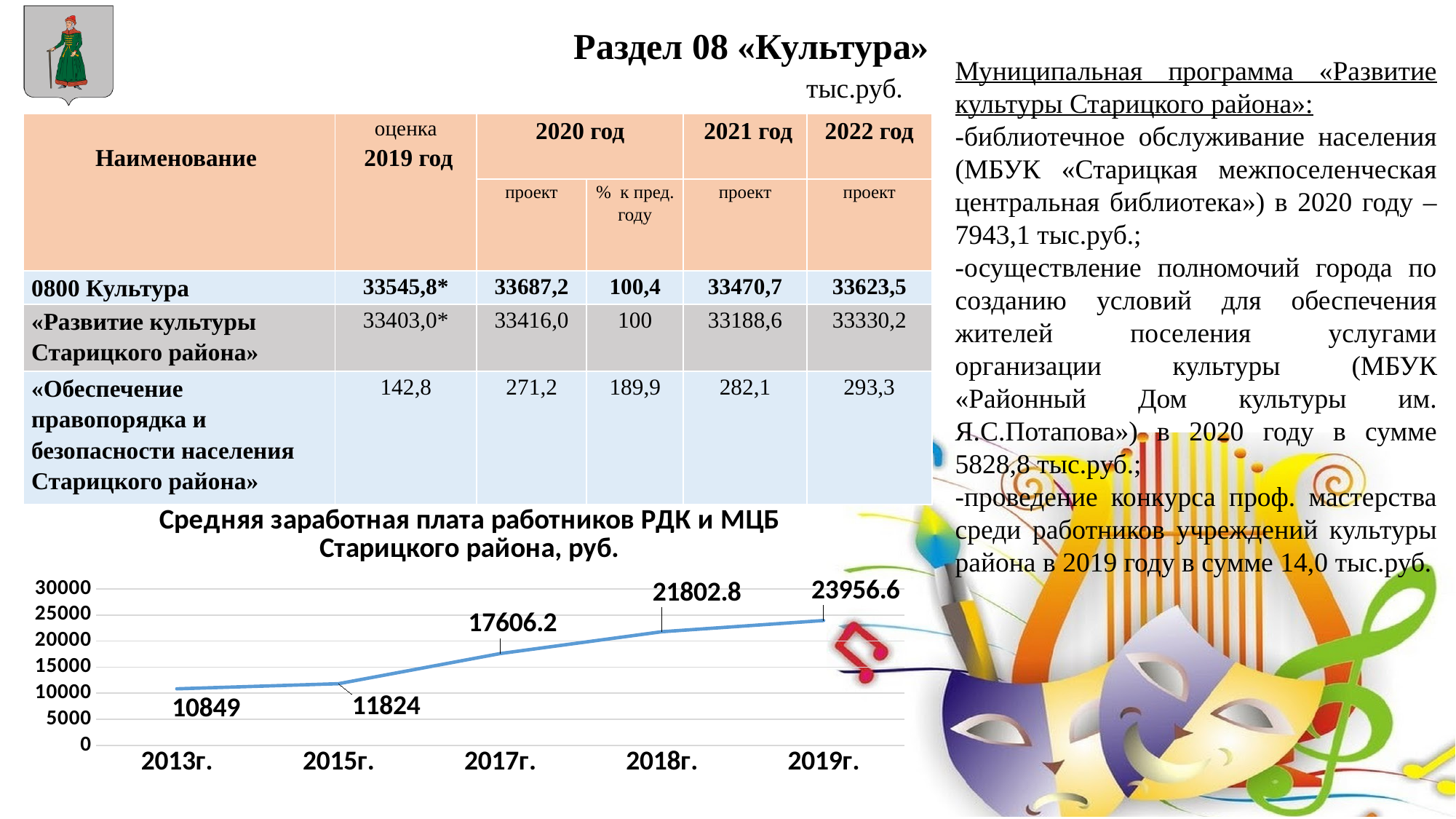
How many data points are plotted in the chart? 5 What is the difference between the values for 2015г. and 2013г.? 975 Do the values rise or fall from 2013г. to 2019г.? rise What is the value for 2013г. in the chart? 10849 What is the title of the chart on the slide? Средняя заработная плата работников РДК и МЦБ Старицкого района, руб. Which is larger, the value for 2017г. or the value for 2018г.? 2018г. What is the value for 2019г. in the chart? 23956.6 Which year has the lowest value in the chart? 2013г. What is the difference between the values for 2019г. and 2018г.? 2153.8 What type of chart is shown on the slide? line chart Which year has the highest value in the chart? 2019г. What is the value for 2017г. in the chart? 17606.2